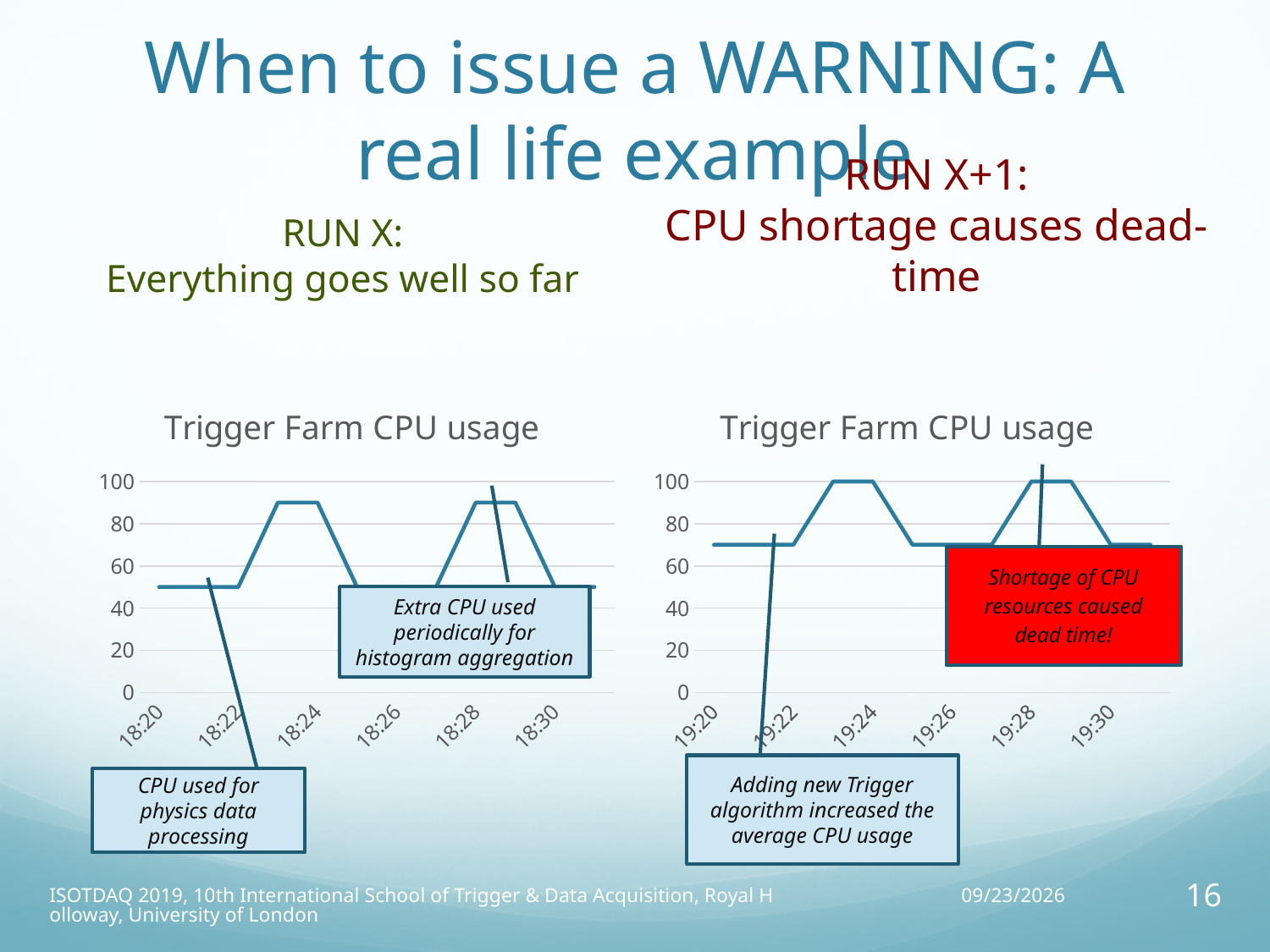
In the right chart (RUN X+1), is the value at 19:26 greater or less than 80? less In the left chart (RUN X), is the baseline value between the peaks greater or less than 40? greater In the right chart (RUN X+1), what value does the line reach at its peak around 19:24? 100 What kind of chart is the left chart, titled 'Trigger Farm CPU usage' under RUN X? line chart Which chart has the higher peak value: the left chart (RUN X) or the right chart (RUN X+1)? the right chart (RUN X+1) In the left chart (RUN X), is the value at 18:24 greater or less than 80? greater What is the highest value shown on the y axis of the left chart (RUN X)? 100 What is the title of the right chart, under RUN X+1? Trigger Farm CPU usage How many time labels are shown on the x axis of the left chart (RUN X)? 6 What is the first time label on the x axis of the right chart (RUN X+1)? 19:20